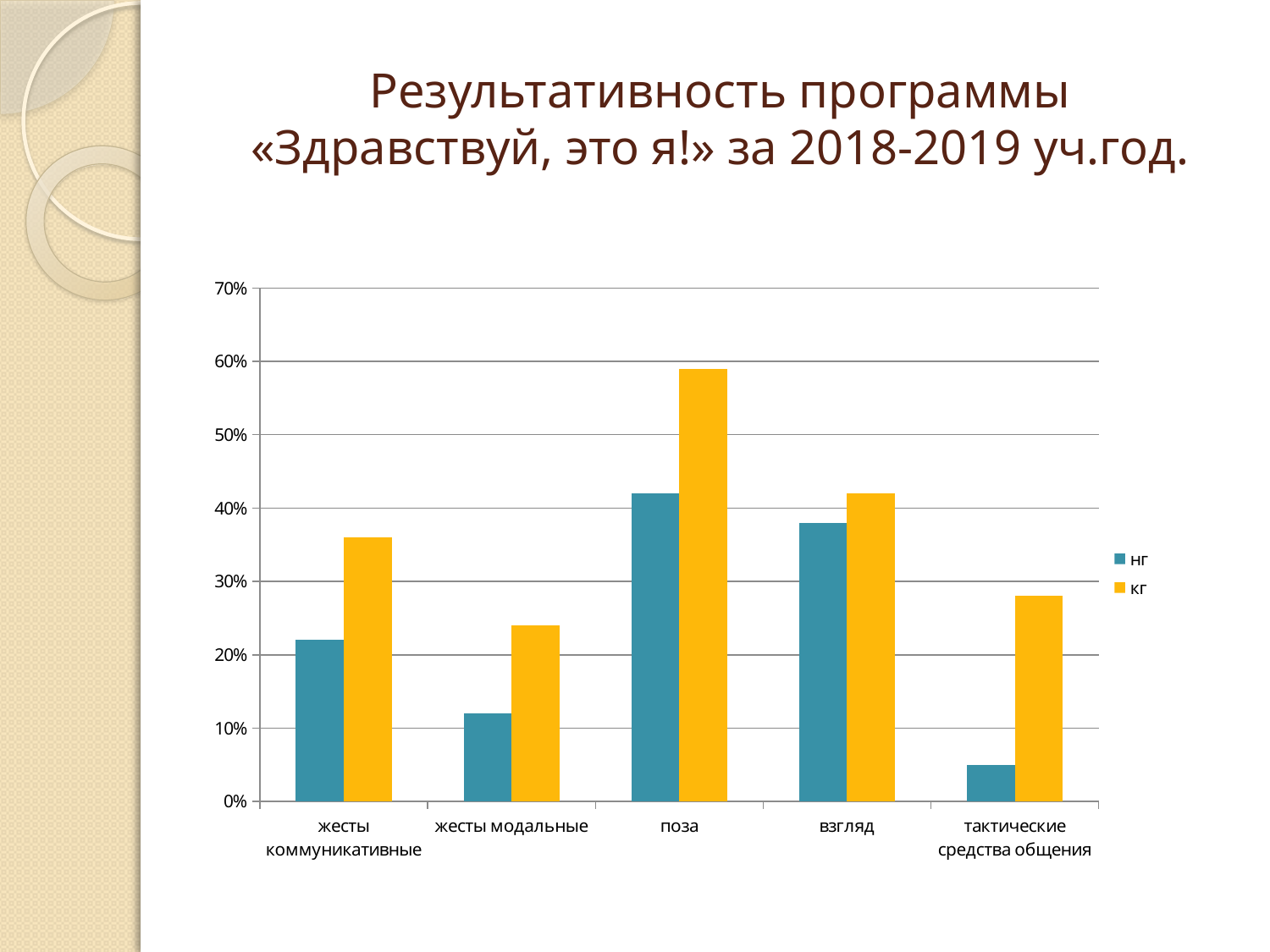
Which category has the lowest value for the кг series? жесты модальные Which category has the lowest value for the нг series? тактические средства общения How many series does the legend list? 2 What kind of chart is shown on the slide? bar chart Is the value for нг in the жесты модальные category greater or less than 20%? less What is the maximum value shown on the vertical axis? 70% Is the value for кг in the поза category greater or less than 50%? greater In the взгляд category, which series has the larger value, нг or кг? кг Is the value for нг in the тактические средства общения category greater or less than 10%? less Which category has the highest value for the кг series? поза How many categories are shown on the x axis of the chart? 5 Which series is shown in yellow in the legend? кг